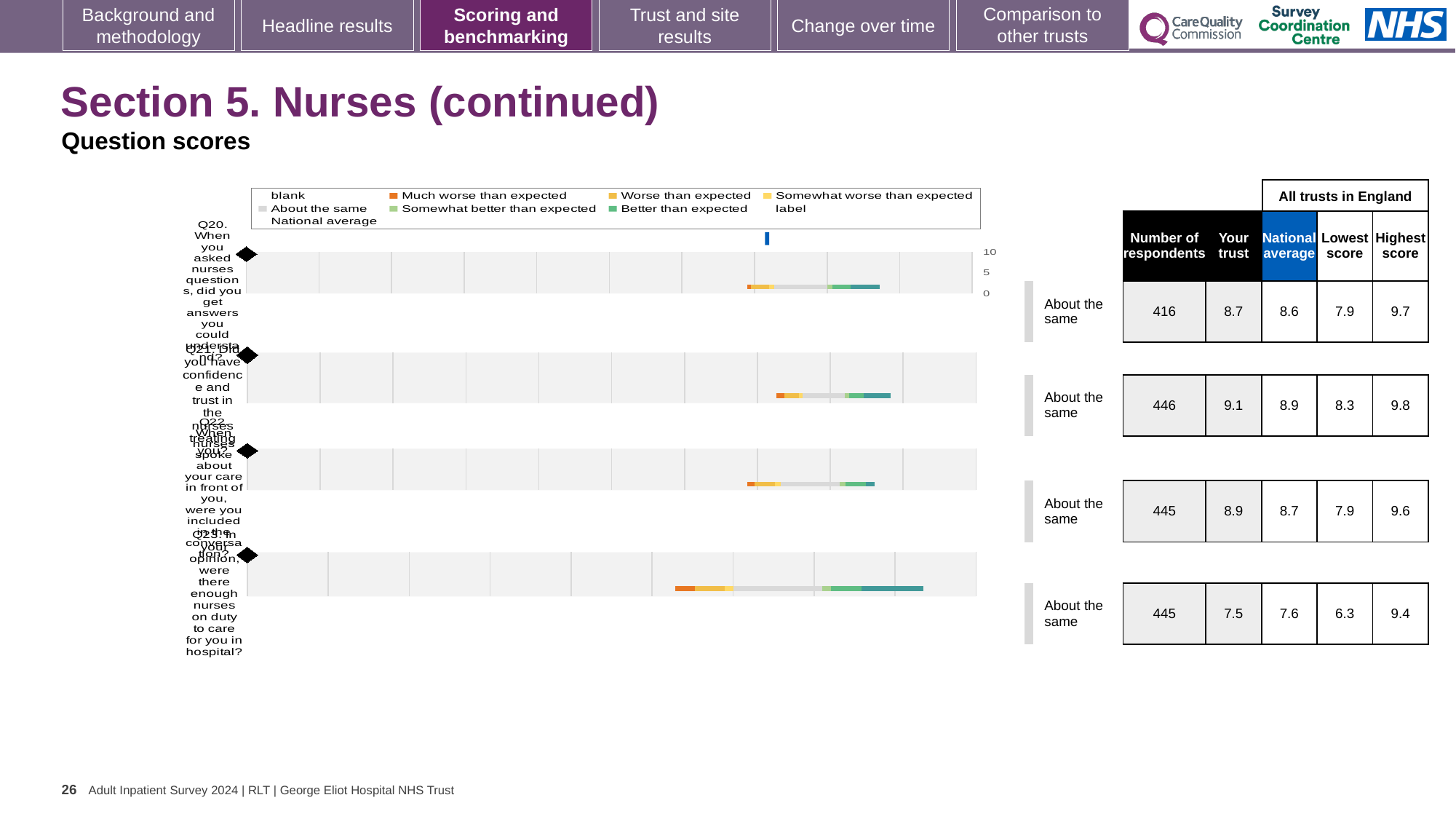
How many entries does the legend above the charts list? 9 For Q22, which is larger: the 'Your trust' score or the 'National average'? Your trust For the Q20 chart, how many respondents are listed in the table? 416 How many question charts (Q20 to Q23) are shown on the slide? 4 For Q23, what is the difference between the highest score and the lowest score across all trusts in England? 3.1 What kind of chart is used to show the question scores on this slide? bar chart In the legend, what colour represents 'Much worse than expected'? orange For the Q21 chart, what is the 'Your trust' score? 9.1 Which question (Q20–Q23) has the highest 'Your trust' score? Q21 Which question (Q20–Q23) has the lowest 'Your trust' score? Q23 What is the highest tick value shown on the score axis of the charts? 10 What benchmark category is shown for the Q23 chart? About the same